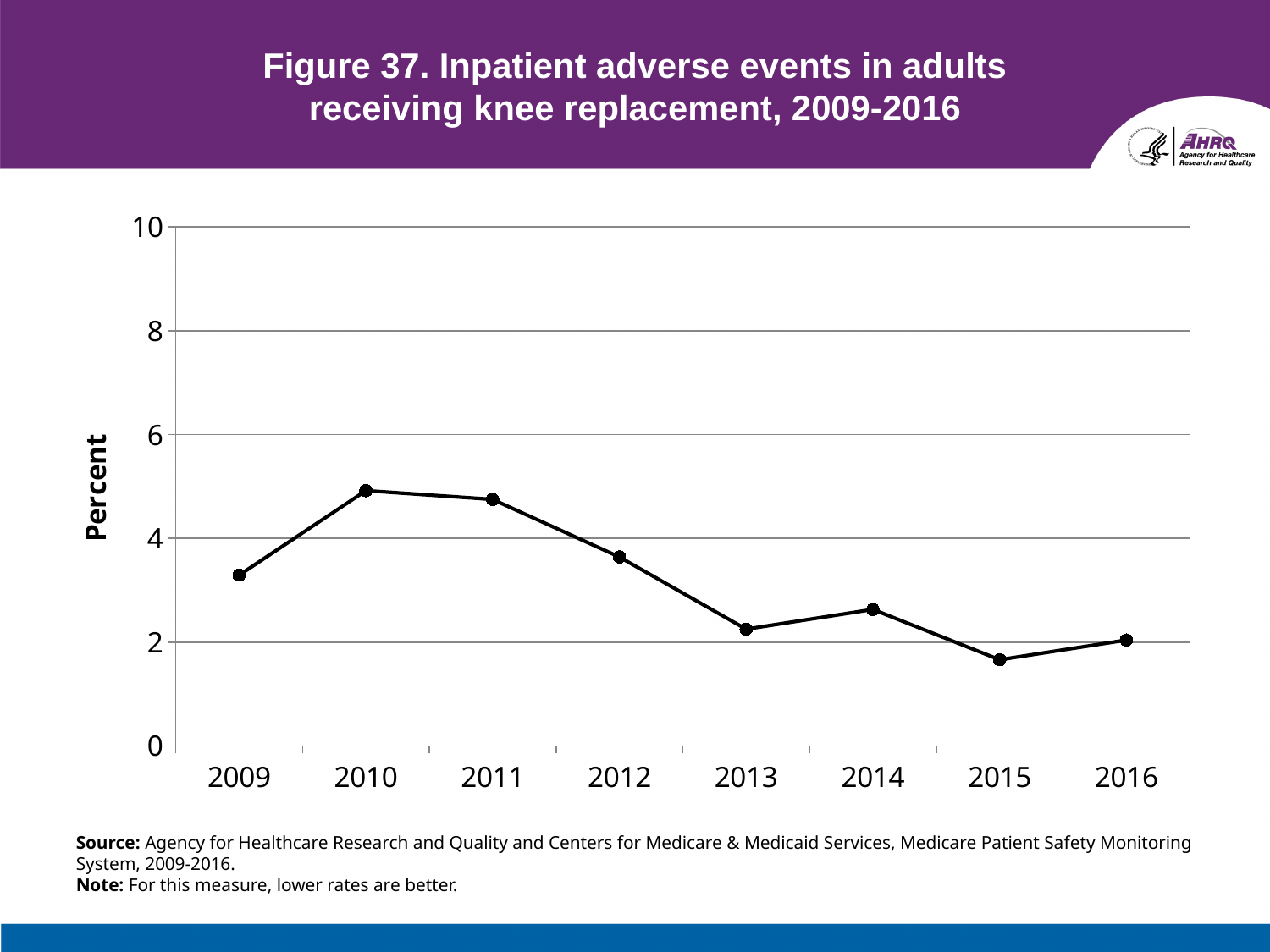
Which year has the highest rate of inpatient adverse events? 2010 Do the values rise or fall from 2011 to 2013? fall Is the value for 2009 greater or less than 4? less Is the value for 2010 greater or less than 4? greater What kind of chart is shown on the slide? line chart Which is larger, the value for 2014 or the value for 2015? 2014 What is the label on the y axis? Percent Is the value for 2013 greater or less than 2? greater Which year has the lowest rate of inpatient adverse events? 2015 How many years are plotted on the x axis? 8 Which is larger, the value for 2009 or the value for 2013? 2009